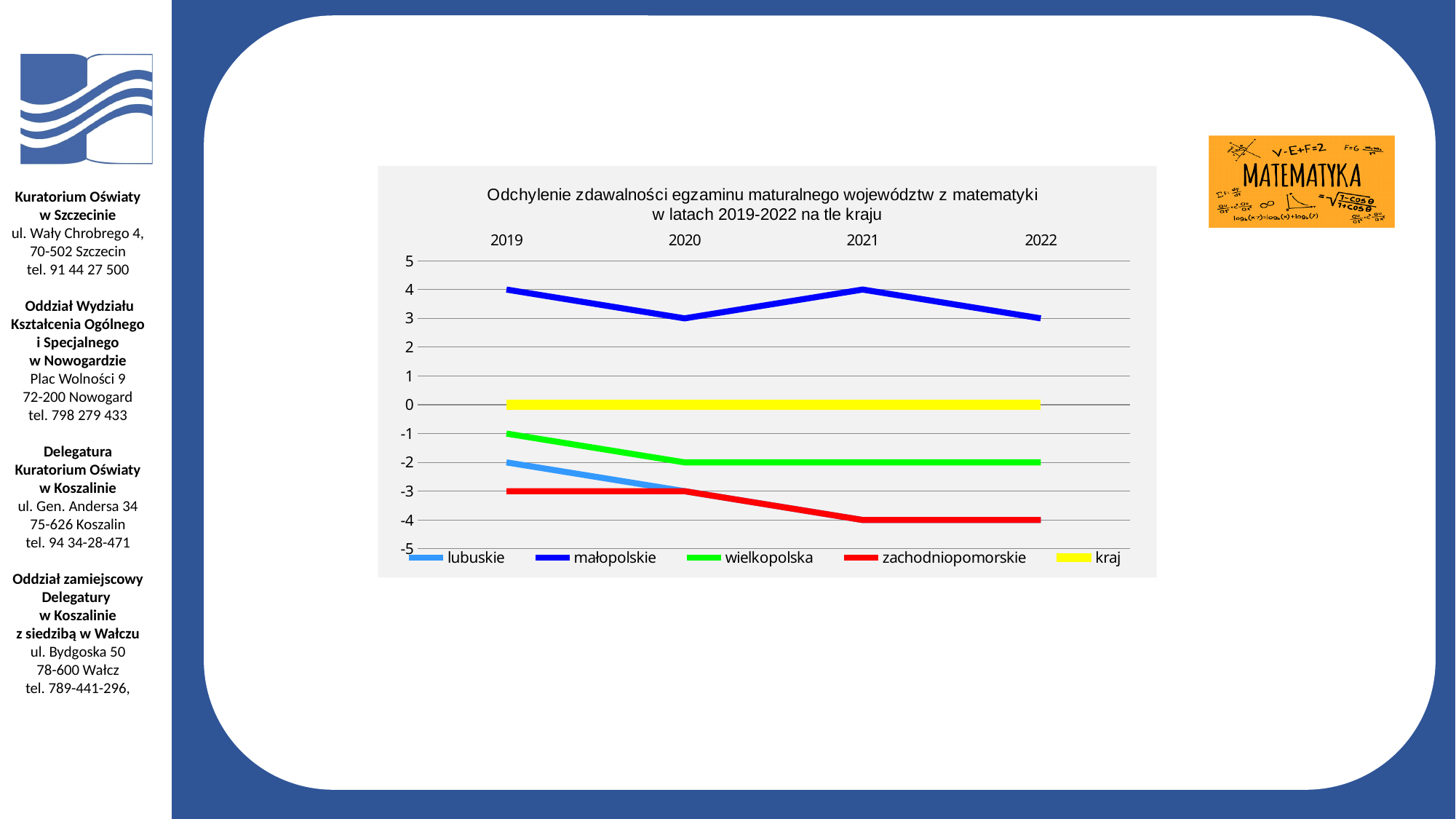
Does the value for zachodniopomorskie rise or fall from 2020 to 2021? fall How many series does the legend list? 5 How many years are shown on the x axis? 4 What is the value for wielkopolska in 2019? -1 Which series has the highest value in 2021? małopolskie What is the value for kraj in 2021? 0 What kind of chart is shown on the slide? line chart What is the value for małopolskie in 2020? 3 What is the difference between the values for małopolskie and zachodniopomorskie in 2021? 8 What is the value for małopolskie in 2019? 4 What is the value for zachodniopomorskie in 2022? -4